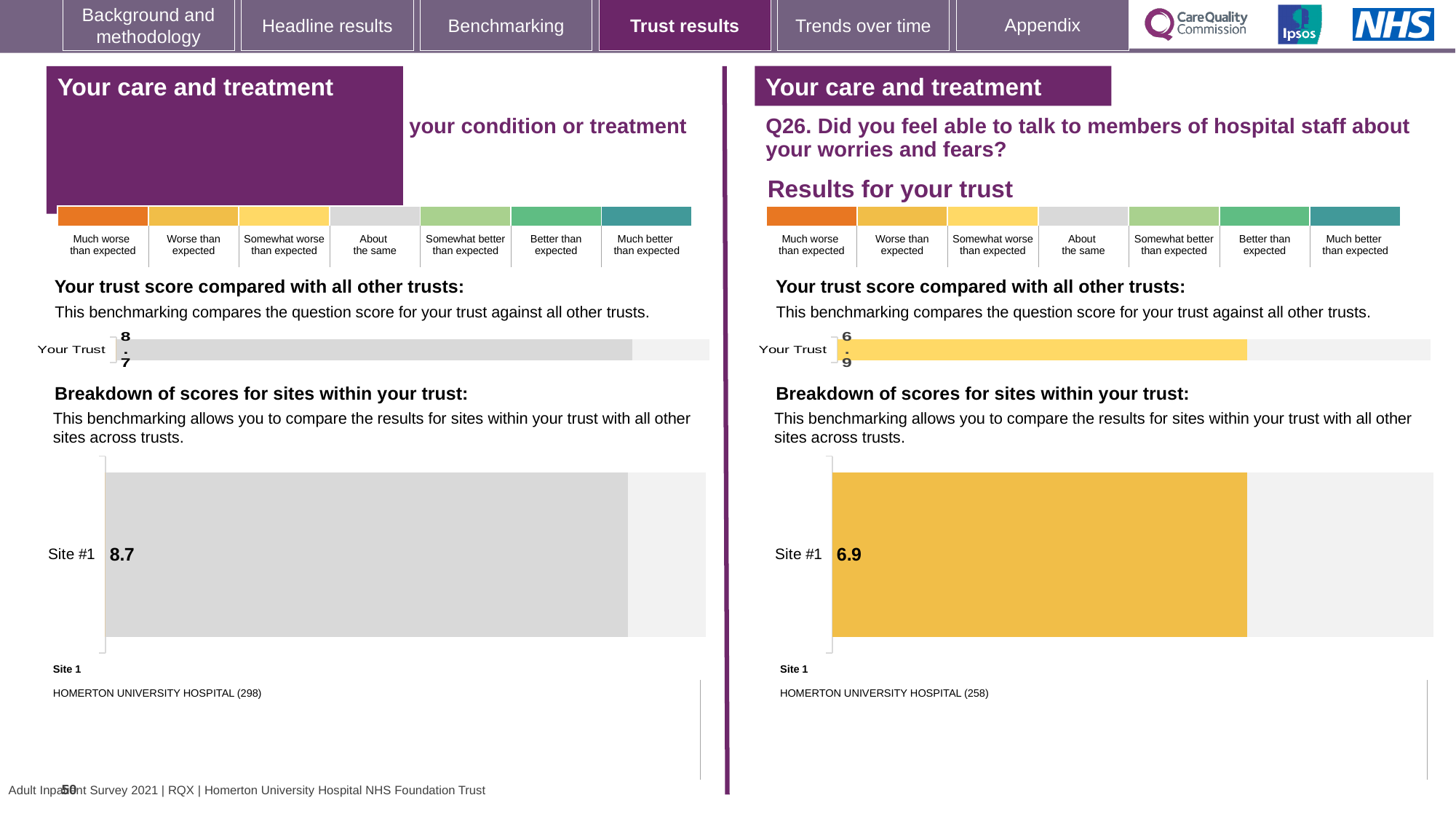
On the right-hand chart for Q26, what is the score shown for Your Trust? 6.9 What is the difference between the Site #1 score on the left-hand chart and the Site #1 score on the right-hand Q26 chart? 1.8 On the left-hand chart, what is the score shown for Your Trust? 8.7 Is the Your Trust score on the right-hand Q26 chart greater or less than 8? less In the right-hand 'Breakdown of scores for sites within your trust' chart for Q26, what is the score for Site #1? 6.9 Which trust score is larger: the one on the left-hand chart or the one on the right-hand Q26 chart? The left-hand chart (8.7) How many sites are shown in the right-hand 'Breakdown of scores for sites within your trust' chart? 1 According to the colour key, which benchmark category does the grey bar on the left-hand chart represent? About the same In the left-hand 'Breakdown of scores for sites within your trust' chart, what is the score for Site #1? 8.7 What kind of chart is used to show the Site #1 score on the right-hand side of the slide? Bar chart According to the colour key, which benchmark category does the yellow bar for Q26 on the right-hand chart represent? Somewhat worse than expected